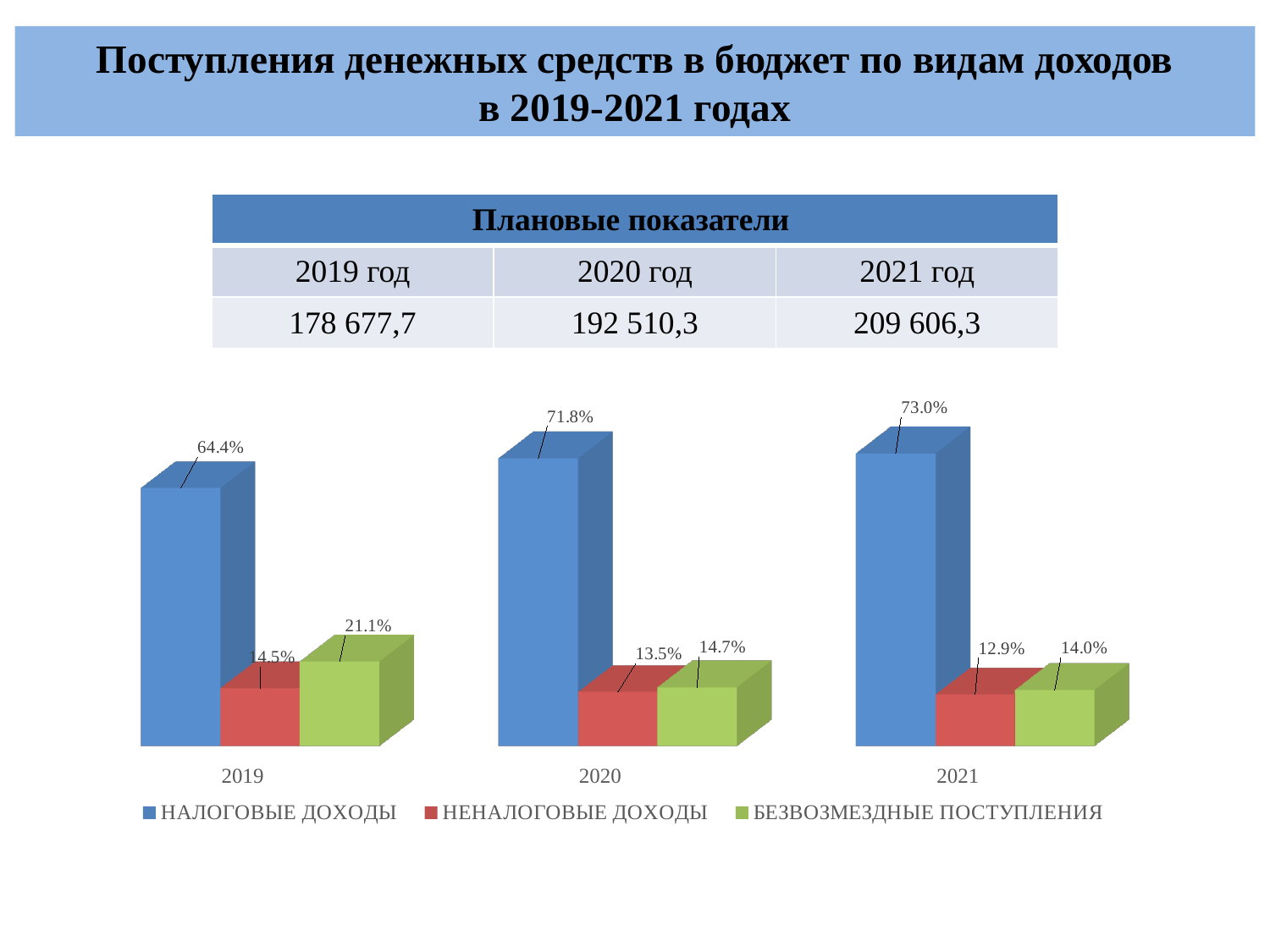
What is the value for НАЛОГОВЫЕ ДОХОДЫ in 2019? 64.4% How many years are shown on the x axis of the chart? 3 In which year is the value for НАЛОГОВЫЕ ДОХОДЫ highest? 2021 What is the value for БЕЗВОЗМЕЗДНЫЕ ПОСТУПЛЕНИЯ in 2020? 14.7% Does the value for НЕНАЛОГОВЫЕ ДОХОДЫ rise or fall from 2019 to 2021? fall Which colour represents НАЛОГОВЫЕ ДОХОДЫ in the chart? blue Which is larger in 2019: НЕНАЛОГОВЫЕ ДОХОДЫ or БЕЗВОЗМЕЗДНЫЕ ПОСТУПЛЕНИЯ? БЕЗВОЗМЕЗДНЫЕ ПОСТУПЛЕНИЯ In which year is the value for БЕЗВОЗМЕЗДНЫЕ ПОСТУПЛЕНИЯ lowest? 2021 What is the difference between the НАЛОГОВЫЕ ДОХОДЫ values for 2021 and 2019? 8.6% What kind of chart is shown on the slide? bar chart How many series does the chart legend list? 3 What is the value for НЕНАЛОГОВЫЕ ДОХОДЫ in 2021? 12.9%